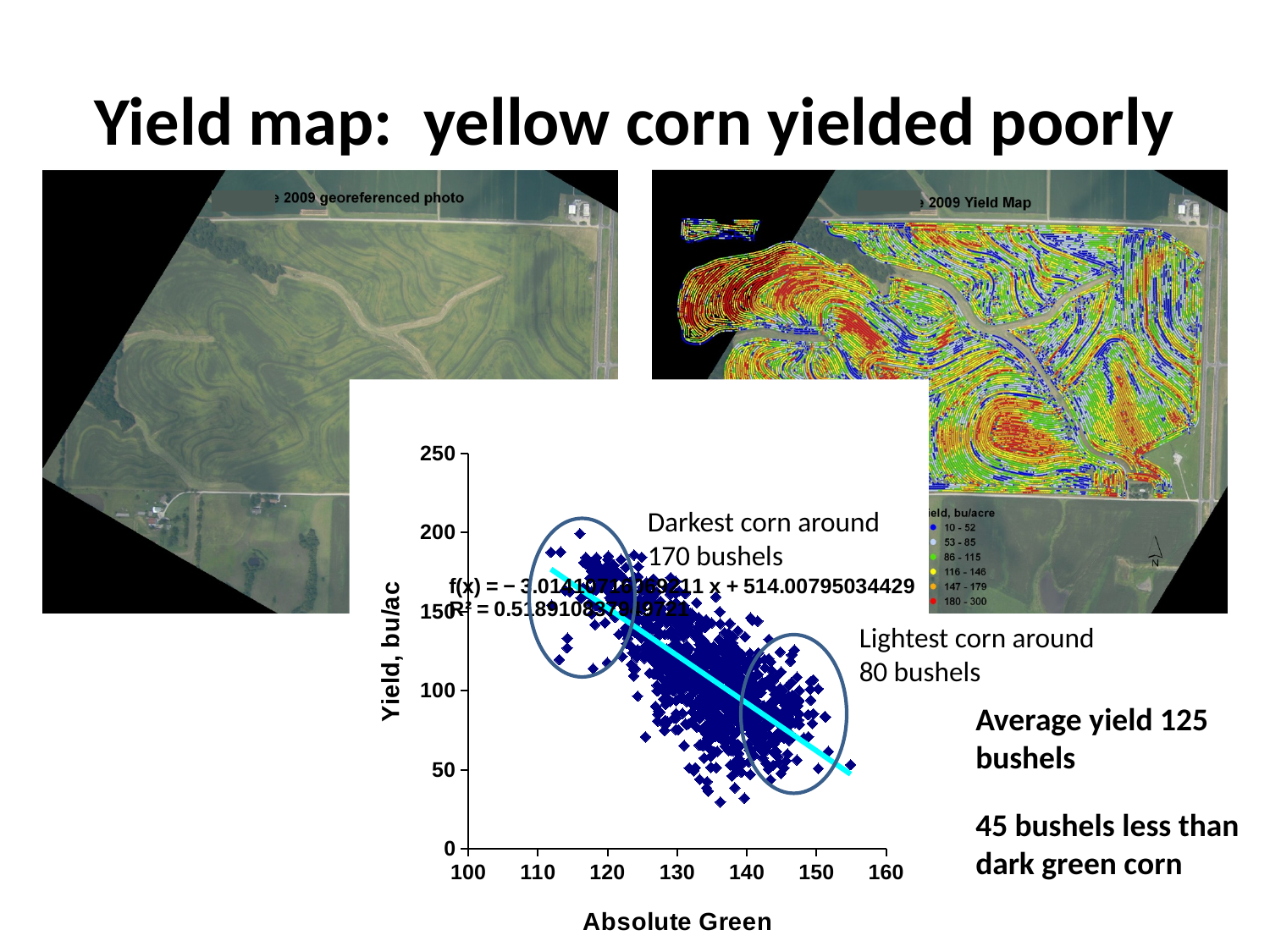
What is the maximum value shown on the y axis of the scatter chart? 250 What is the label of the y axis of the scatter chart? Yield, bu/ac Is the trendline value at an Absolute Green of 150 greater or less than 100 bu/ac? less According to the annotation on the scatter chart, around how many bushels did the darkest corn yield? 170 bushels What is the label of the x axis of the scatter chart? Absolute Green Is the trendline value at an Absolute Green of 130 greater or less than 100 bu/ac? greater What kind of chart is shown on the slide? Scatter chart Which yielded more according to the chart annotations, the darkest corn or the lightest corn? Darkest corn What average yield is stated next to the scatter chart? 125 bushels As Absolute Green increases along the x axis, does yield tend to rise or fall? Fall Is the trendline value at an Absolute Green of 110 greater or less than 150 bu/ac? greater According to the annotation on the scatter chart, around how many bushels did the lightest corn yield? 80 bushels